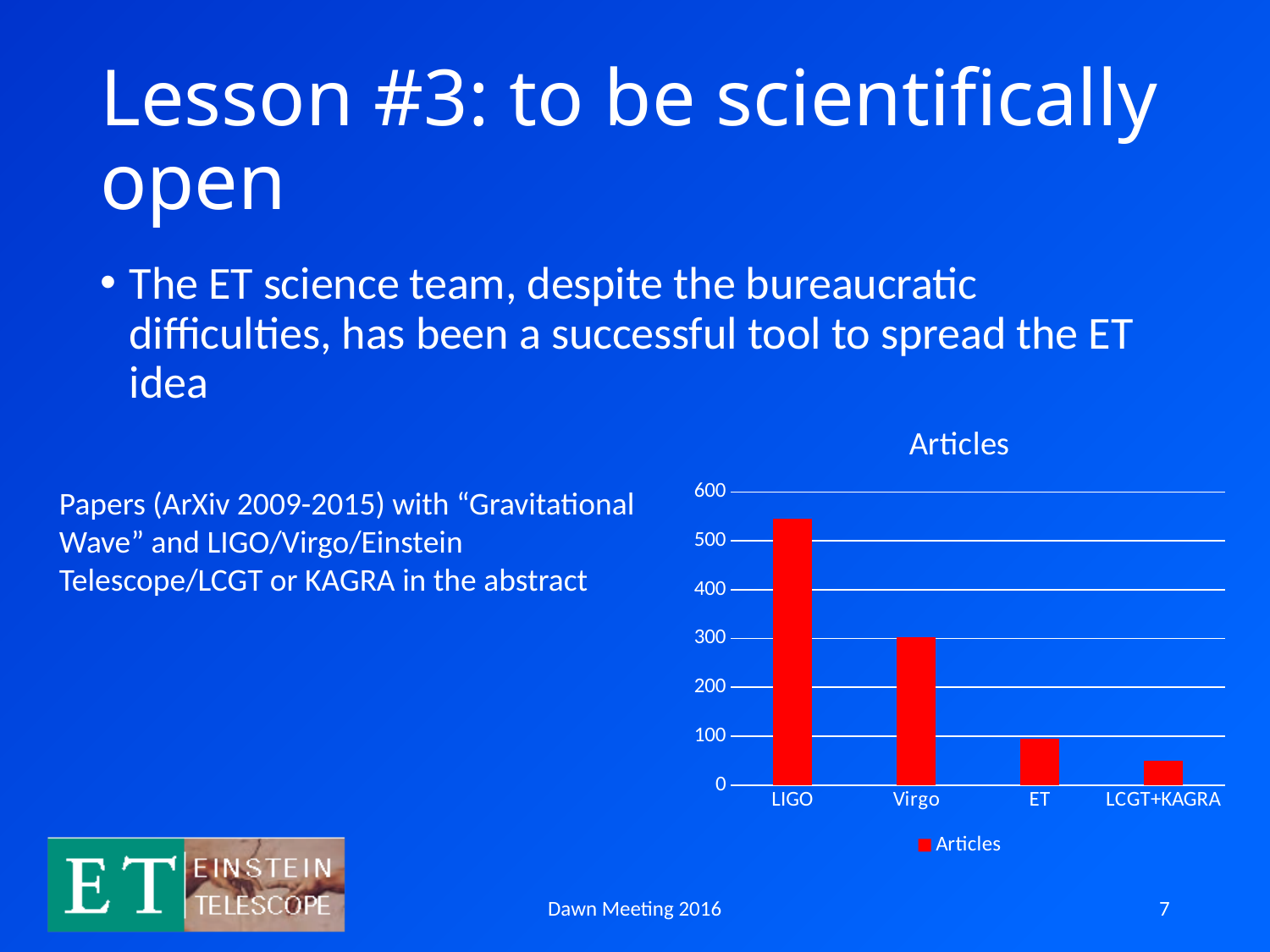
How many series does the chart legend list? 1 What is the title of the chart? Articles What colour are the bars in the chart? red Which category has the lowest number of articles? LCGT+KAGRA Is the value for LCGT+KAGRA greater or less than 100? less How many categories are shown on the x axis of the chart? 4 Is the value for ET greater or less than 200? less Which has more articles, Virgo or ET? Virgo What kind of chart is shown on the slide? bar chart Is the value for LIGO greater or less than 500? greater Which category has the highest number of articles? LIGO Do the values rise or fall moving from LIGO to LCGT+KAGRA along the x axis? fall